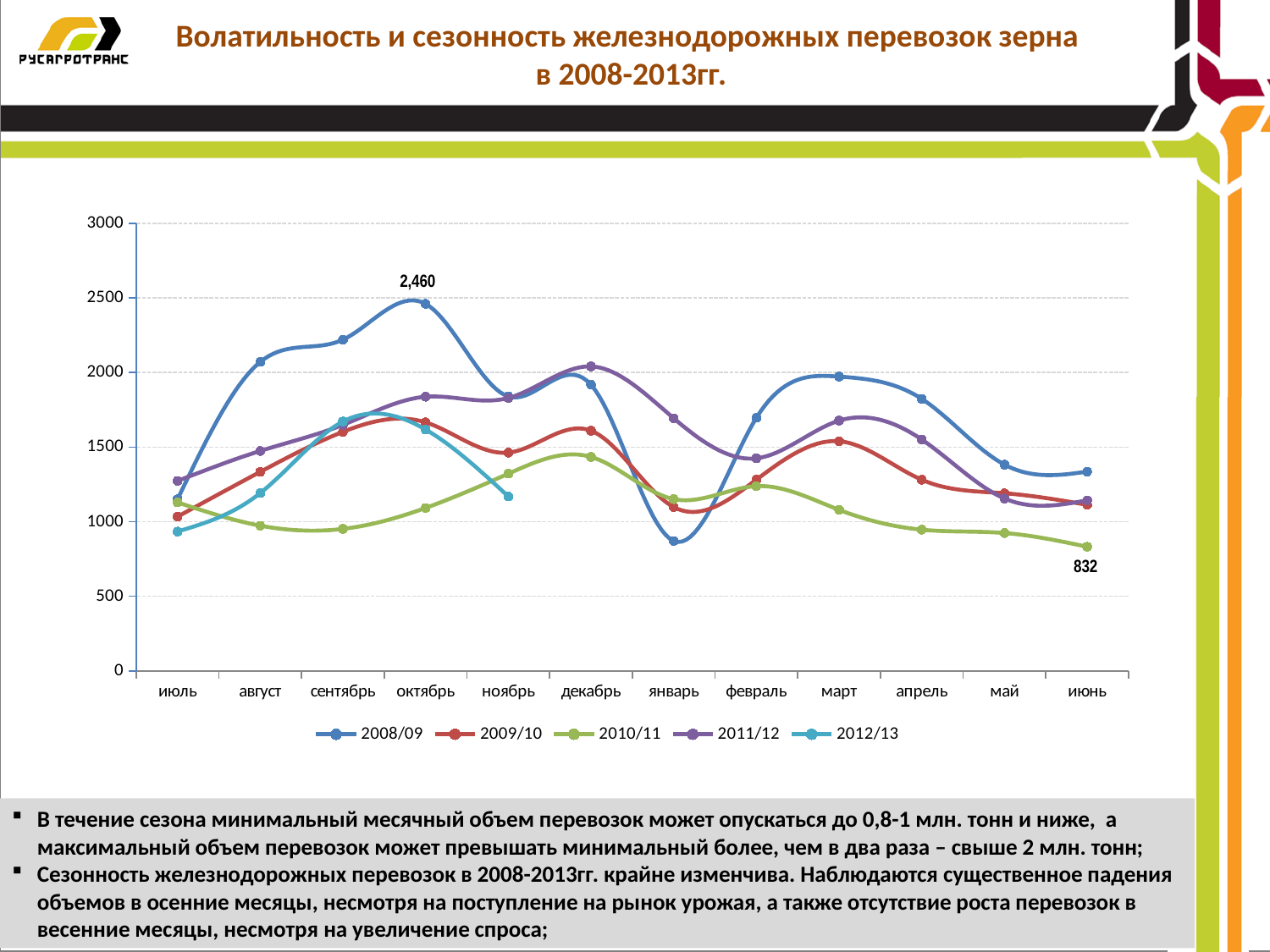
Does the 2010/11 series rise or fall from март to июнь? Fall In which month does the 2008/09 series reach its lowest value? январь What is the labelled value for the 2008/09 series in октябрь? 2,460 What kind of chart is shown on the slide? Line chart What is the difference between the labelled peak of 2008/09 in октябрь (2,460) and the labelled value of 2010/11 in июнь (832)? 1,628 In which month does the 2008/09 series reach its highest value? октябрь How many series does the legend list? 5 How many months are shown along the x axis? 12 Is the value for the 2012/13 series in ноябрь greater or less than 1500? less What is the labelled value for the 2010/11 series in июнь? 832 Is the value for the 2008/09 series in январь greater or less than 1000? less In март, which series has the larger value: 2008/09 or 2010/11? 2008/09